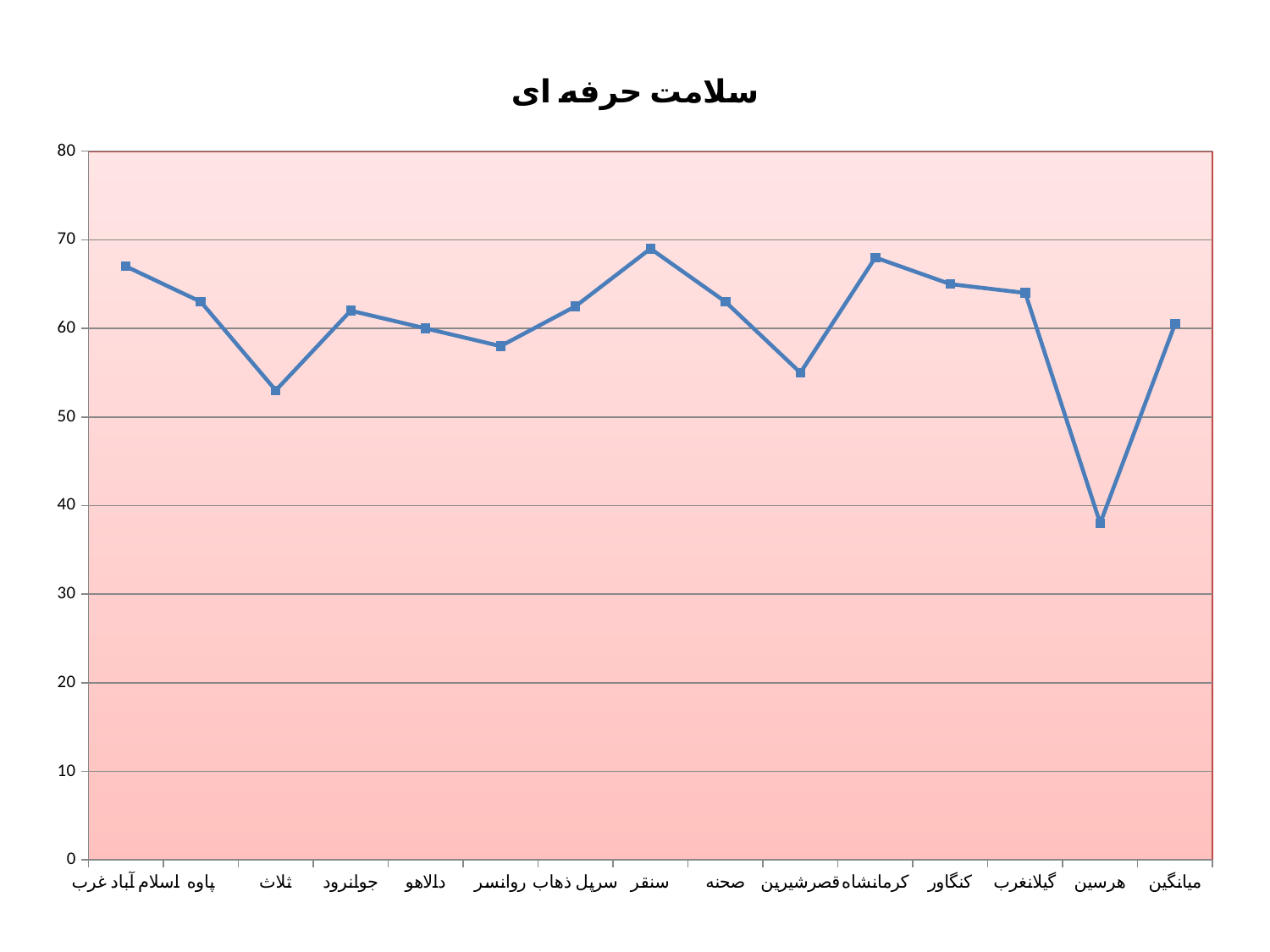
Is the value for قصرشیرین greater or less than 60? less What kind of chart is shown on the slide? line chart What is the title of the chart? سلامت حرفه ای Is the value for ثلاث greater or less than 60? less How many categories are plotted along the x axis? 15 Is the value for اسلام آباد غرب greater or less than 60? greater Which category has the lowest value? هرسین Which has the larger value, اسلام آباد غرب or پاوه? اسلام آباد غرب Which has the larger value, ثلاث or هرسین? ثلاث Which has the larger value, سنقر or قصرشیرین? سنقر